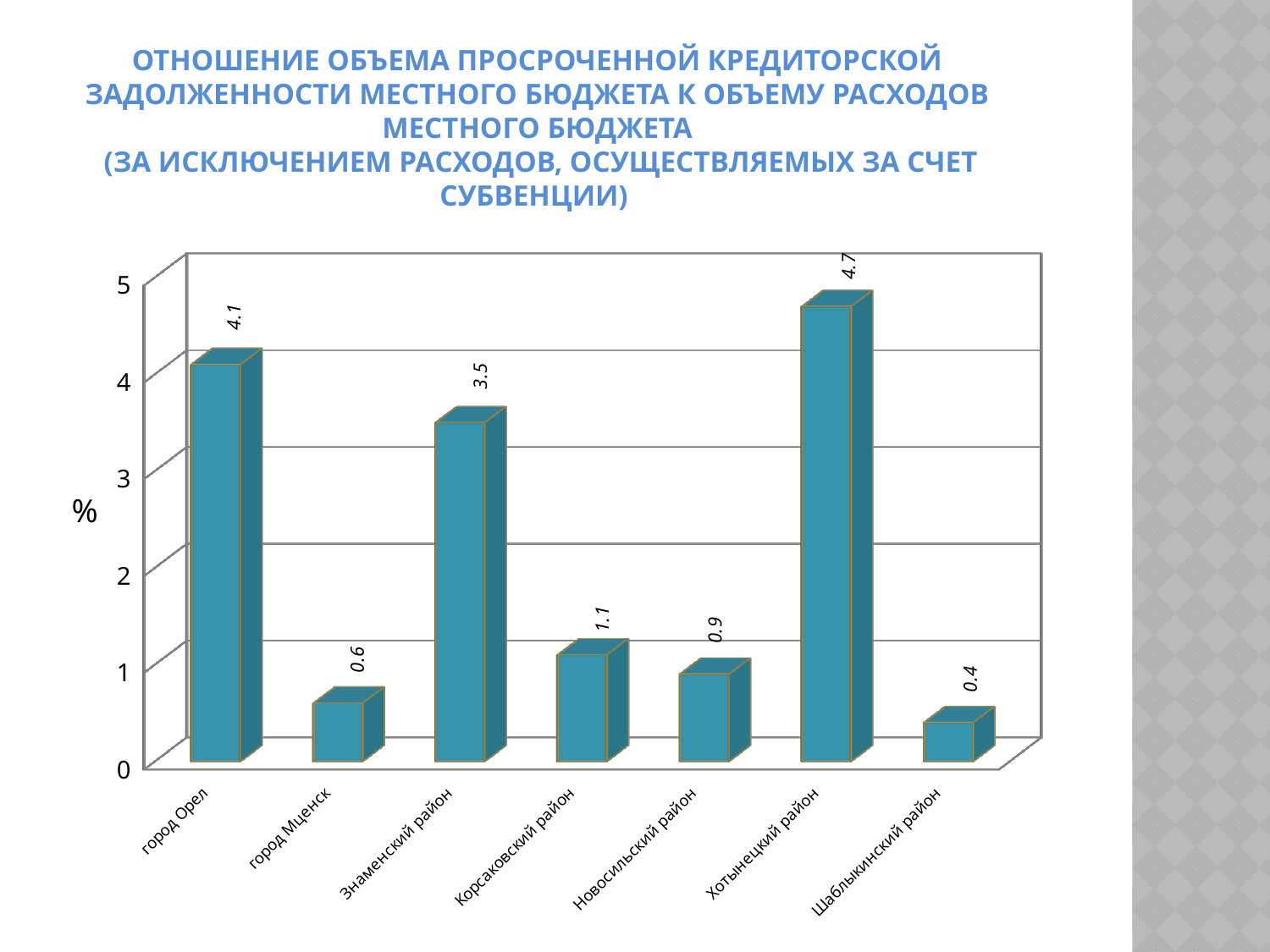
Which is larger, the value for Корсаковский район or Новосильский район? Корсаковский район What unit is shown on the vertical axis label? % What kind of chart is shown on the slide? bar chart How many categories are shown on the chart? 7 Which category has the highest value? Хотынецкий район What is the value for Шаблыкинский район? 0.4 Is the value for город Мценск greater or less than 1? less What is the value for Знаменский район? 3.5 What is the difference between the values for Хотынецкий район and город Орел? 0.6 What is the value for Хотынецкий район? 4.7 Which category has the lowest value? Шаблыкинский район What is the value for город Орел? 4.1